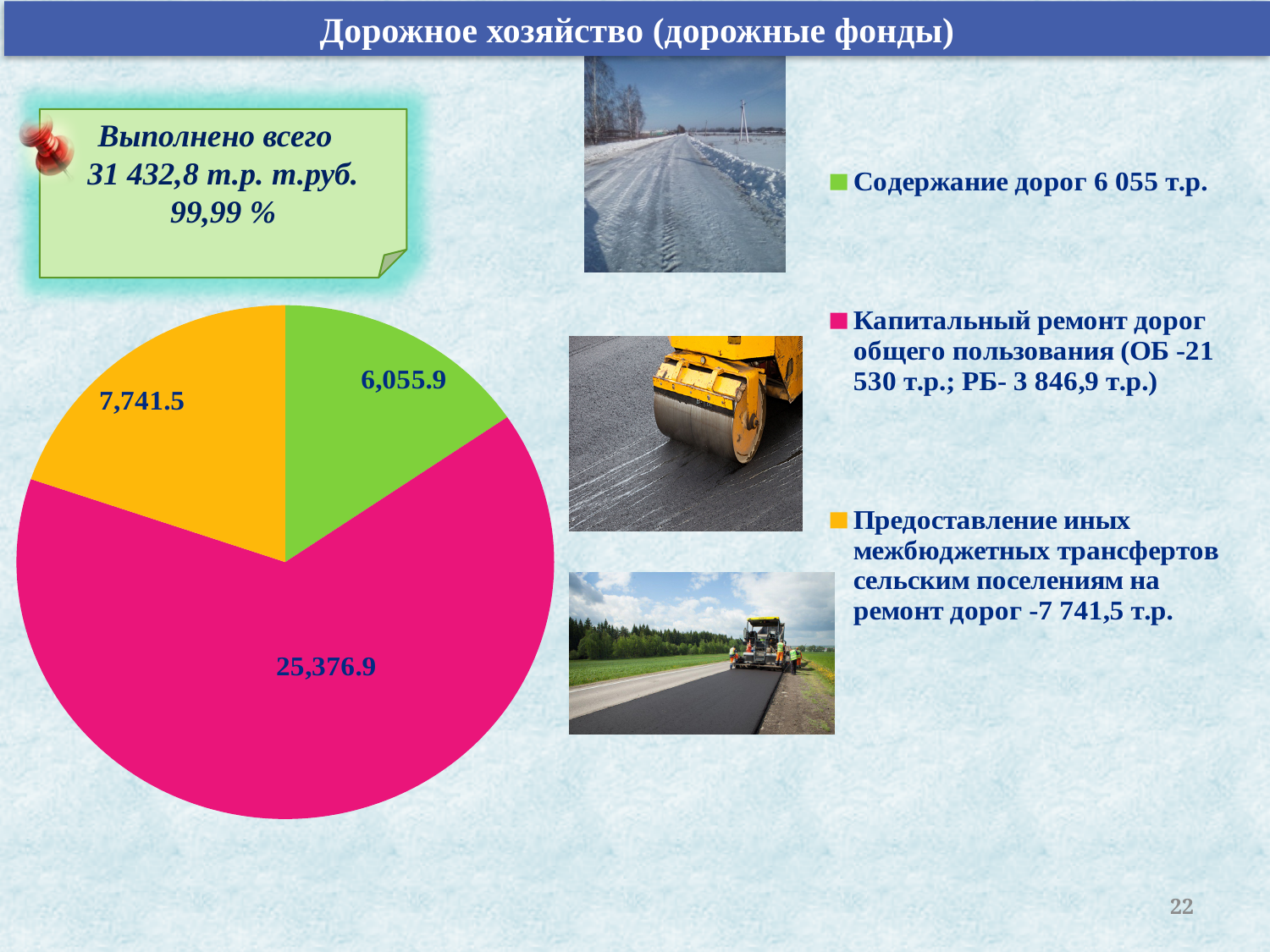
What colour is the 'Содержание дорог' slice in the pie chart? Green How many slices does the pie chart have? 3 What type of chart is shown on the slide? Pie chart Which category has the largest slice in the pie chart? Капитальный ремонт дорог общего пользования What value is shown for the 'Содержание дорог' slice of the pie chart? 6,055.9 What is the difference between the 'Предоставление иных межбюджетных трансфертов' value and the 'Содержание дорог' value in the pie chart? 1,685.6 What is the difference between the 'Капитальный ремонт дорог общего пользования' value and the 'Содержание дорог' value in the pie chart? 19,321.0 How many entries does the legend of the pie chart list? 3 Which category has the smallest slice in the pie chart? Содержание дорог Which is larger in the pie chart: 'Содержание дорог' or 'Предоставление иных межбюджетных трансфертов сельским поселениям на ремонт дорог'? Предоставление иных межбюджетных трансфертов сельским поселениям на ремонт дорог What value is shown for the 'Капитальный ремонт дорог общего пользования' slice of the pie chart? 25,376.9 What value is shown for the 'Предоставление иных межбюджетных трансфертов сельским поселениям на ремонт дорог' slice of the pie chart? 7,741.5